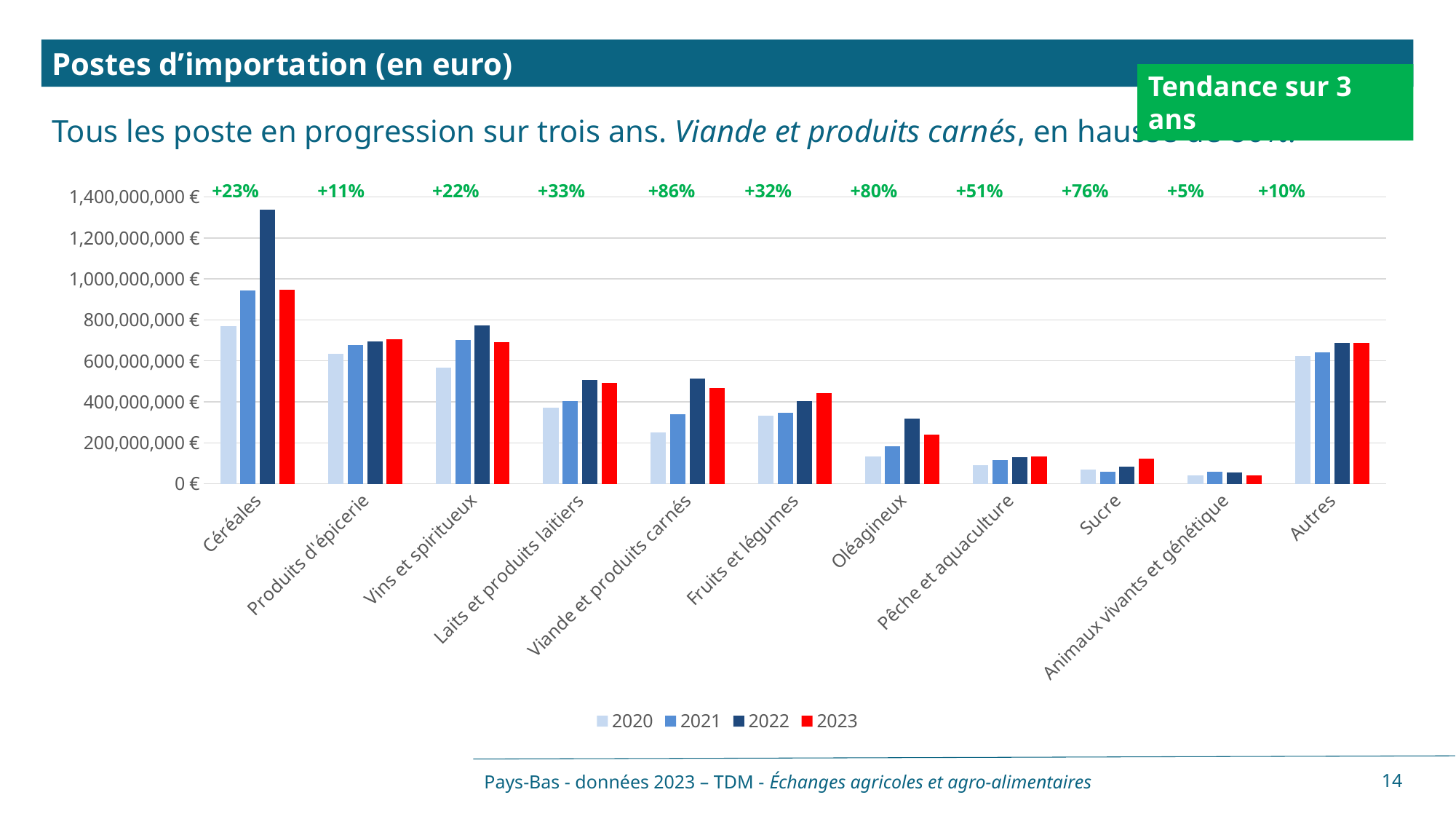
For Céréales, which year has the larger value: 2022 or 2023? 2022 Which colour represents the 2023 series in the legend? red Is the 2022 value for Céréales greater or less than 1,200,000,000 €? greater How many import categories are shown along the x axis? 11 How many series does the legend list? 4 Which category has the lowest three-year trend percentage? Animaux vivants et génétique What is the difference in percentage points between the trend for Viande et produits carnés and the trend for Animaux vivants et génétique? 81 What kind of chart is shown on the slide? bar chart What three-year trend percentage is shown above Animaux vivants et génétique? +5% What three-year trend percentage is shown above Viande et produits carnés? +86% Is the 2023 value for Sucre greater or less than 200,000,000 €? less Which category has the highest three-year trend percentage? Viande et produits carnés